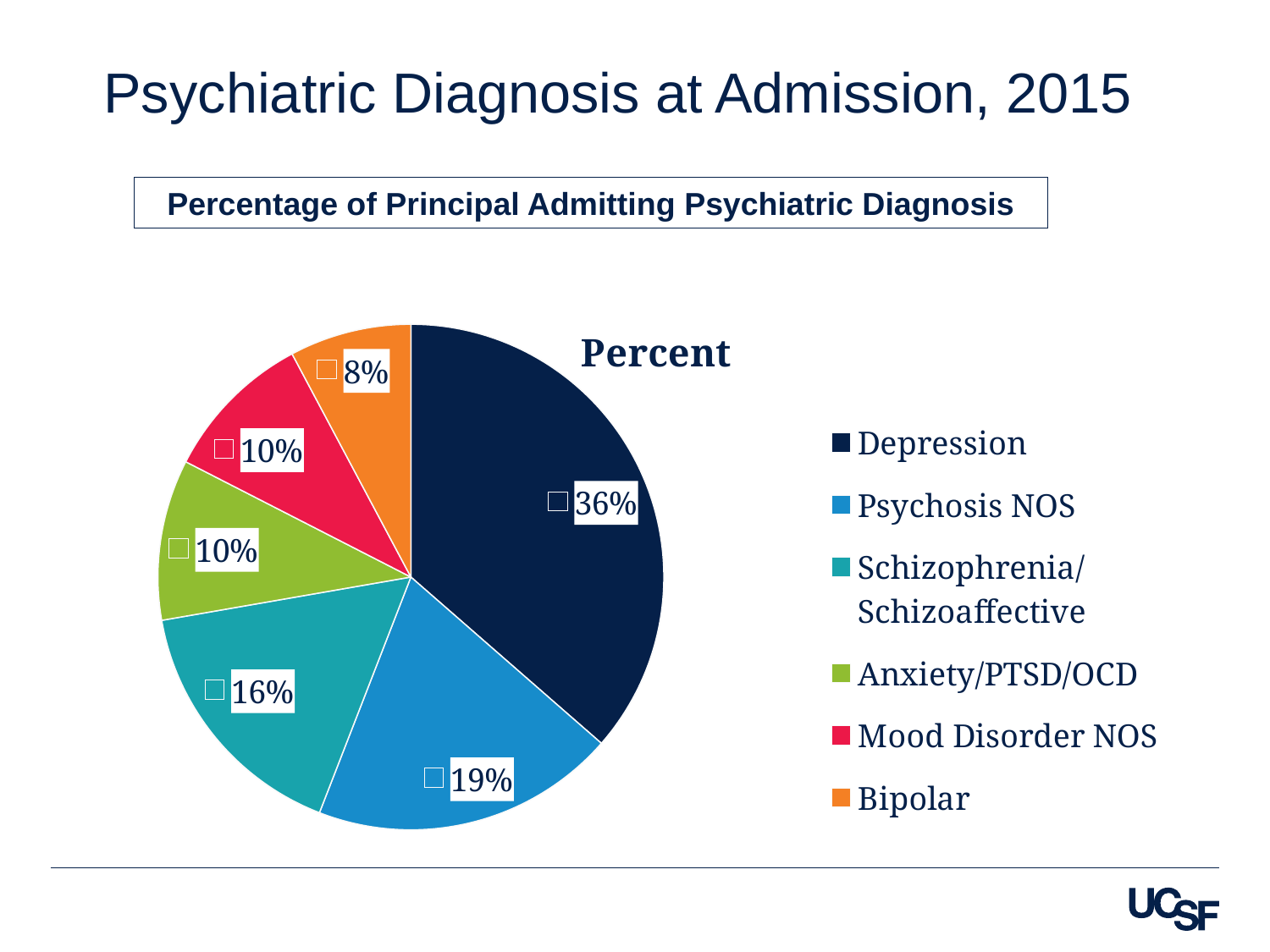
What is the title shown inside the chart area? Percent Which diagnosis has the largest share of the pie? Depression How many diagnosis categories are shown in the pie chart? 6 What is the difference in percentage points between Depression and Psychosis NOS? 17 What kind of chart is shown on the slide? Pie chart Which two diagnoses each account for 10% of the pie? Anxiety/PTSD/OCD and Mood Disorder NOS What percentage of principal admitting diagnoses is Depression? 36% What percentage is shown for Psychosis NOS? 19% Which is larger, the share for Schizophrenia/Schizoaffective or the share for Mood Disorder NOS? Schizophrenia/Schizoaffective What percentage is shown for Bipolar? 8% Which diagnosis has the smallest share of the pie? Bipolar What percentage is shown for Schizophrenia/Schizoaffective? 16%